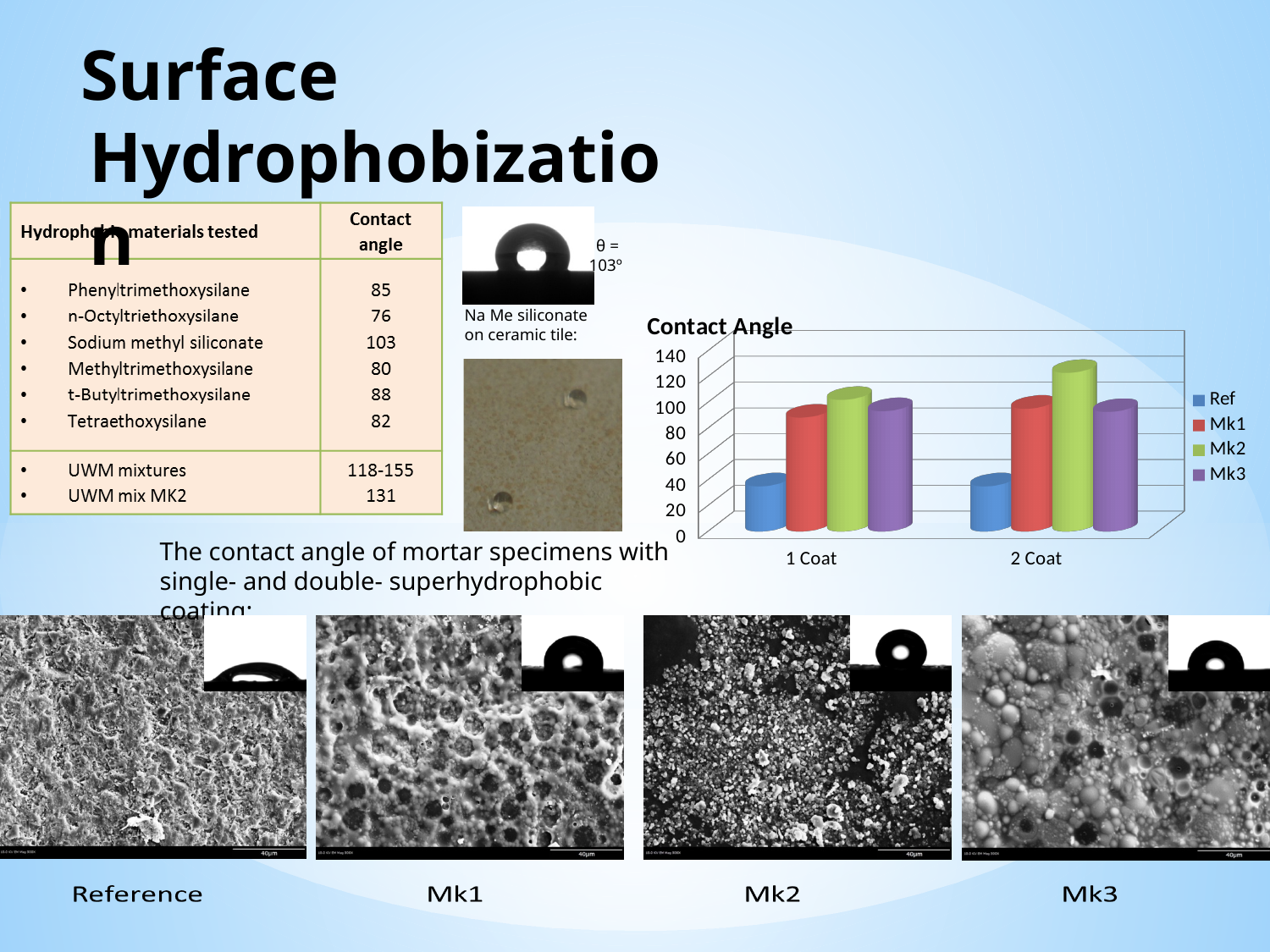
What is the title of the chart on the slide? Contact Angle In the Contact Angle chart, which series has the lowest value for 1 Coat? Ref In the Contact Angle chart, which colour represents the Ref series? blue What kind of chart is the Contact Angle chart? bar chart In the Contact Angle chart, which series has the highest value for 2 Coat? Mk2 In the Contact Angle chart, which is larger for 1 Coat: Mk2 or Ref? Mk2 How many categories are shown on the x axis of the Contact Angle chart? 2 In the Contact Angle chart, is the value for Mk2 at 2 Coat greater or less than 100? greater In the Contact Angle chart, is the value for Ref at 1 Coat greater or less than 60? less In the Contact Angle chart, is the value for Mk1 at 1 Coat greater or less than 80? greater In the Contact Angle chart, is the Mk2 value larger for 1 Coat or for 2 Coat? 2 Coat How many series does the legend of the Contact Angle chart list? 4